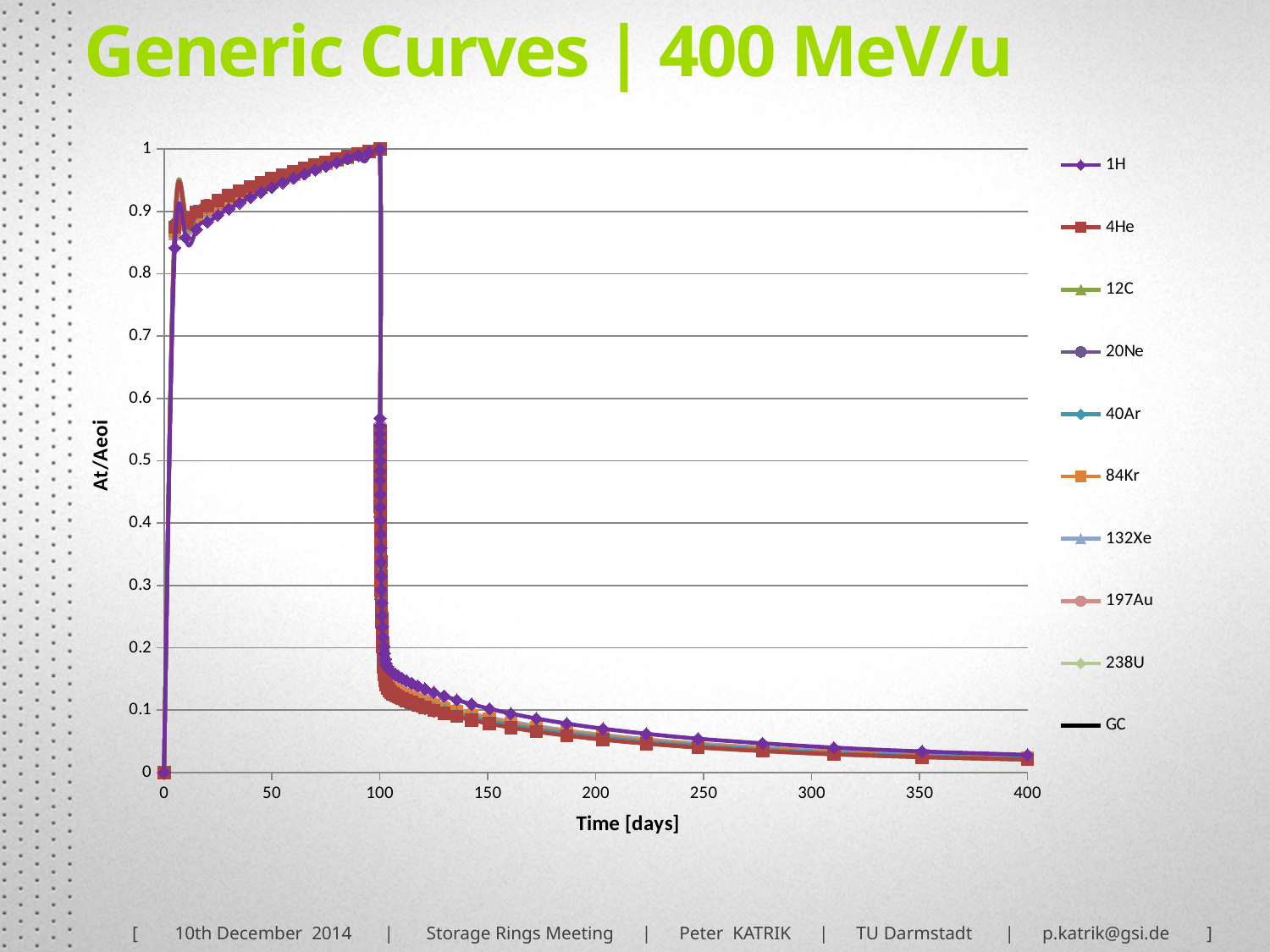
Is the value of the curves at 400 days greater or less than 0.1? less Is the value of the curves at 50 days greater or less than 0.9? greater What is the maximum value reached by the curves, at about 100 days? 1 Do the curves rise or fall between 150 days and 400 days? fall What kind of chart is shown on the slide? line chart How many series does the legend list? 10 Is the value of the curves at 200 days greater or less than 0.1? less What is the label of the x axis? Time [days] What is the highest value shown on the x axis? 400 What is the label of the y axis? At/Aeoi Do the curves rise or fall between 20 days and 100 days? rise